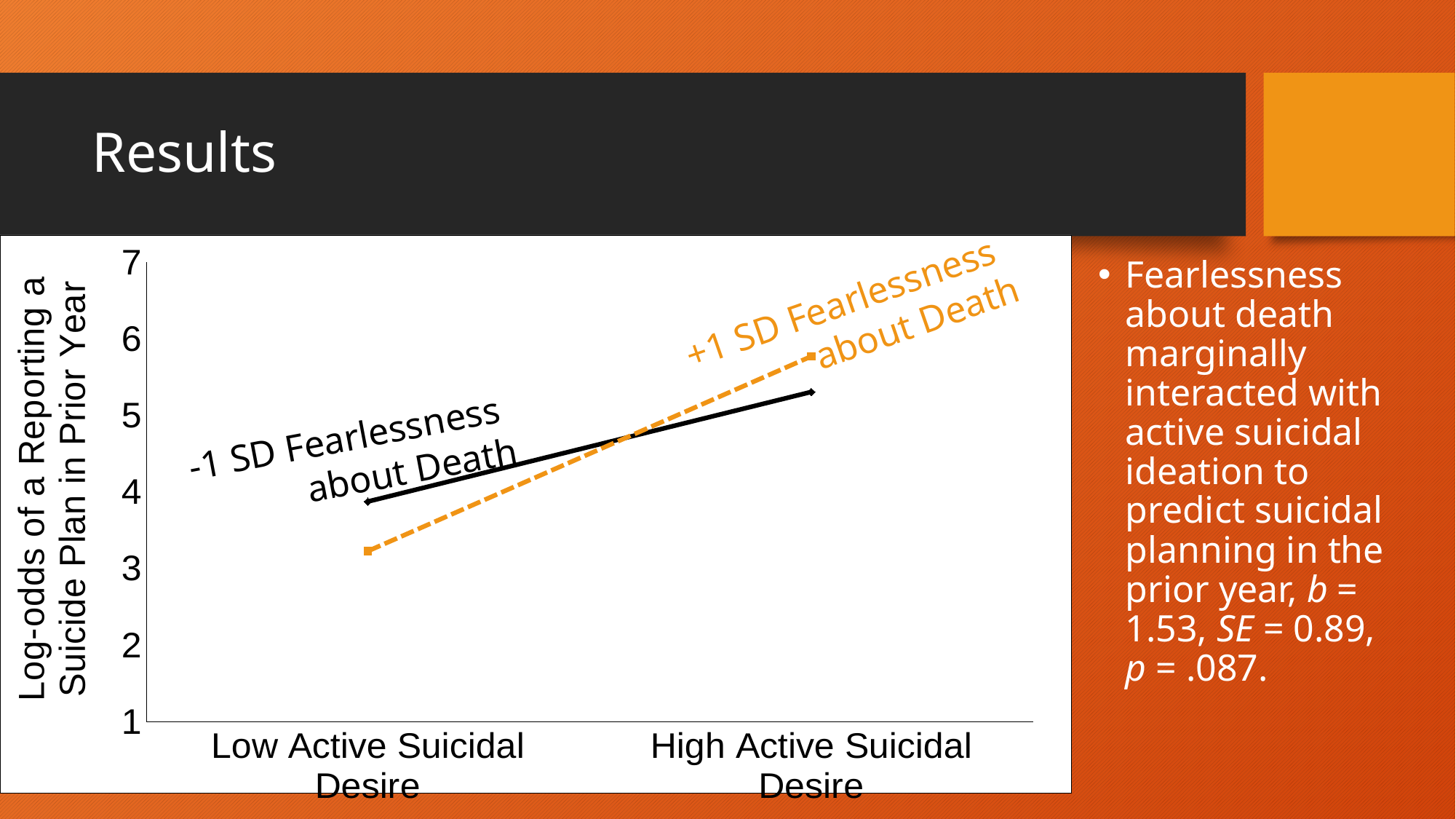
Does the +1 SD Fearlessness about Death line rise or fall from Low Active Suicidal Desire to High Active Suicidal Desire? rise Is the value for +1 SD Fearlessness about Death at High Active Suicidal Desire greater or less than 5? greater Is the value for +1 SD Fearlessness about Death at Low Active Suicidal Desire greater or less than 4? less How many categories are shown on the x axis? 2 Does the -1 SD Fearlessness about Death line rise or fall from Low Active Suicidal Desire to High Active Suicidal Desire? rise At Low Active Suicidal Desire, which line is higher: -1 SD Fearlessness about Death or +1 SD Fearlessness about Death? -1 SD Fearlessness about Death What kind of chart is shown on the slide? line chart Is the value for -1 SD Fearlessness about Death at High Active Suicidal Desire greater or less than 6? less How many series (lines) are plotted on the chart? 2 At High Active Suicidal Desire, which line is higher: -1 SD Fearlessness about Death or +1 SD Fearlessness about Death? +1 SD Fearlessness about Death What is the title of the y axis of the chart? Log-odds of a Reporting a Suicide Plan in Prior Year